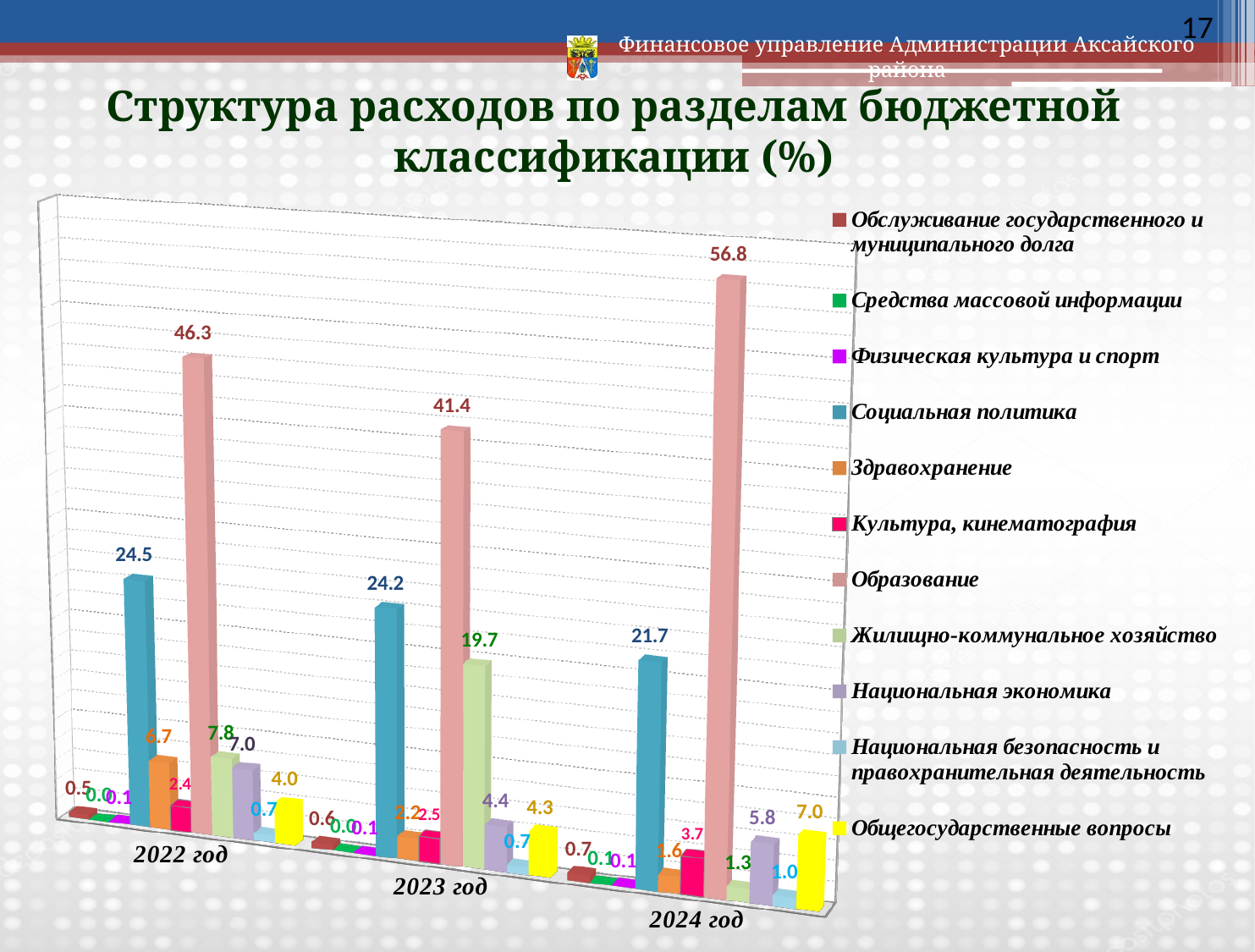
What is the value for Социальная политика in 2022 год? 24.5 How many series does the legend list? 11 What is the value for Жилищно-коммунальное хозяйство in 2023 год? 19.7 Which is larger: Здравохранение in 2022 год or Здравохранение in 2024 год? 2022 год Which year has the highest value for Образование? 2024 год What is the value for Образование in 2024 год? 56.8 Does the value for Социальная политика rise or fall from 2022 год to 2024 год? fall What is the difference between the Образование values for 2024 год and 2023 год? 15.4 Which year has the lowest value for Социальная политика? 2024 год What kind of chart is shown on the slide? bar chart What is the value for Общегосударственные вопросы in 2024 год? 7.0 How many years are shown on the x axis? 3